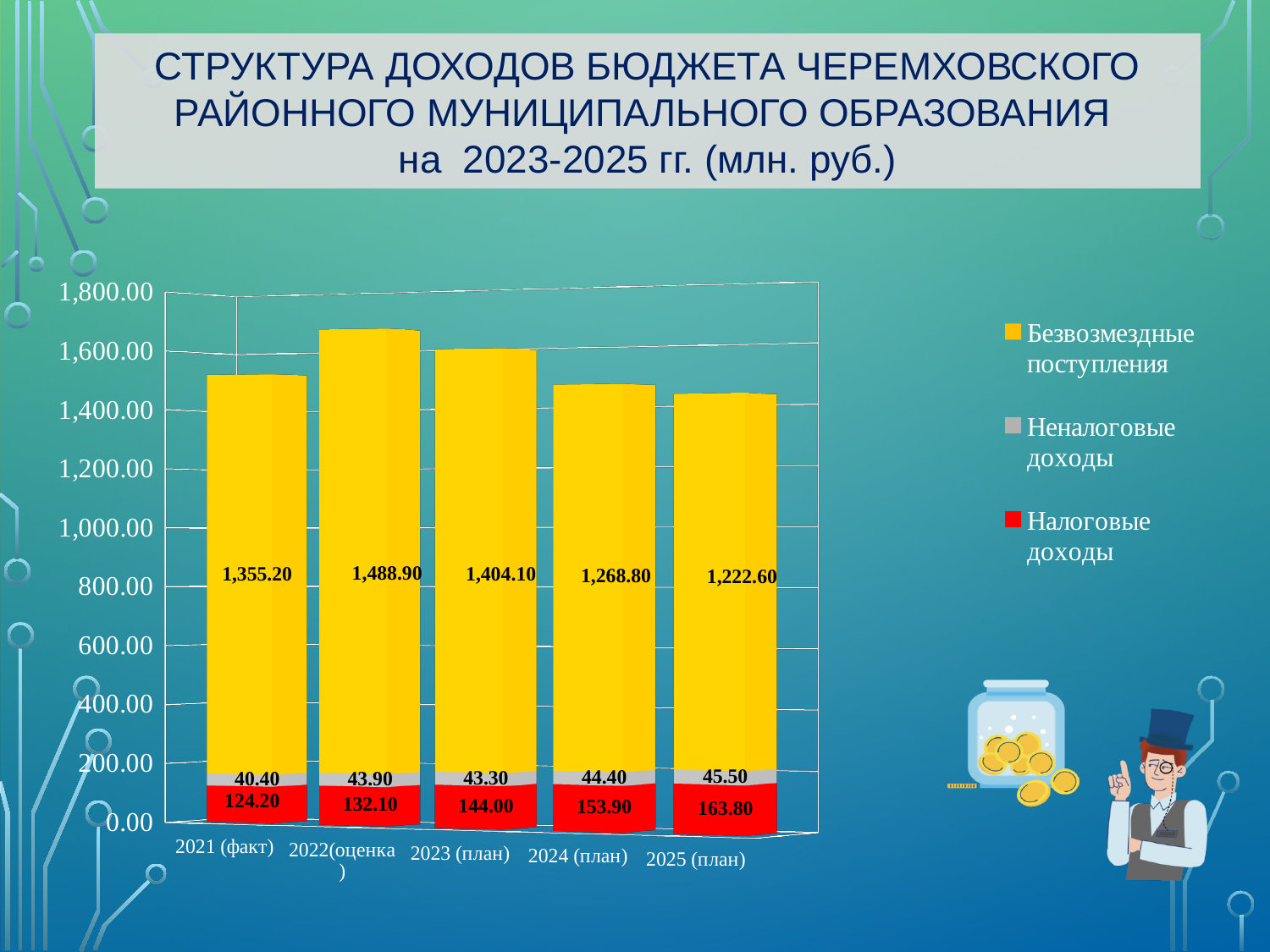
Which is larger: Налоговые доходы in 2024 (план) or in 2023 (план)? 2024 (план) What is the value of Налоговые доходы for 2025 (план)? 163.80 What is the difference between Безвозмездные поступления in 2021 (факт) and 2025 (план)? 132.60 In which category is Безвозмездные поступления the highest? 2022(оценка) How many series does the legend list? 3 What is the value of Неналоговые доходы for 2023 (план)? 43.30 How many categories are shown on the x axis? 5 What is the total of the stacked bar for 2025 (план)? 1,431.90 In which category is Налоговые доходы the lowest? 2021 (факт) What is the value of Безвозмездные поступления for 2022(оценка)? 1,488.90 Do the values of Налоговые доходы rise or fall from 2021 (факт) to 2025 (план)? Rise What type of chart is shown on the slide? Stacked bar chart